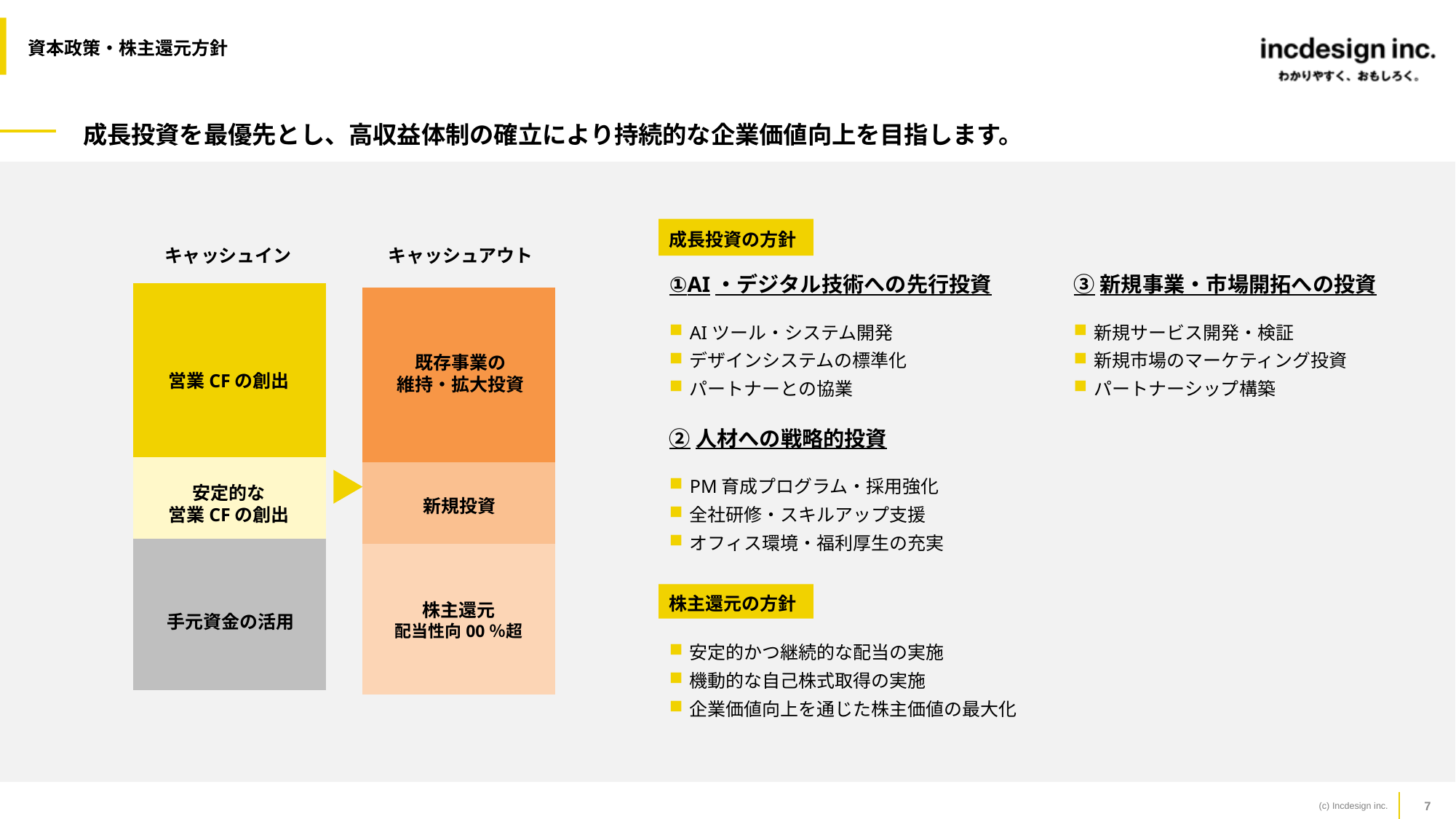
In the cash flow diagram on the left, what is the label of the top segment of the キャッシュイン bar? 営業CFの創出 In the cash flow diagram on the left, how many segments make up the キャッシュイン bar? 3 In the cash flow diagram on the left, how many segments make up the キャッシュアウト bar? 3 In the cash flow diagram on the left, what colour is the 手元資金の活用 segment? Grey In the cash flow diagram on the left, what is the label of the bottom segment of the キャッシュアウト bar? 株主還元 配当性向00%超 In the cash flow diagram on the left, what colour is the 営業CFの創出 segment? Yellow